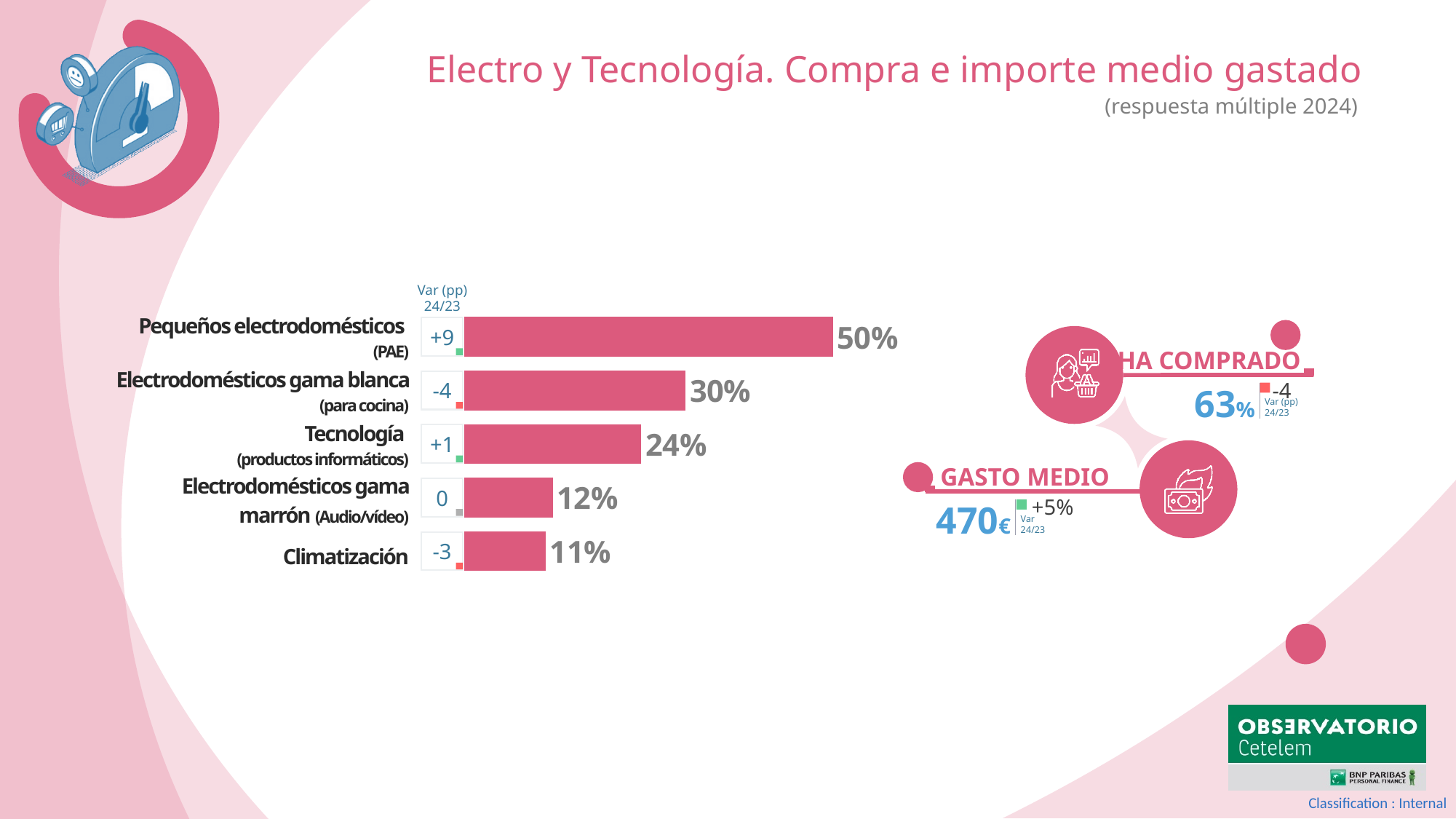
What is the Var (pp) 24/23 value shown for Electrodomésticos gama blanca? -4 What kind of chart is used to show the purchase percentages by category? Bar chart Which category has the highest percentage in the bar chart? Pequeños electrodomésticos (PAE) What percentage is shown for Climatización? 11% What is the difference in percentage points between Pequeños electrodomésticos and Electrodomésticos gama blanca? 20 What is the Var (pp) 24/23 value shown for Pequeños electrodomésticos? +9 What percentage is shown for Tecnología (productos informáticos)? 24% What percentage is shown for Pequeños electrodomésticos (PAE)? 50% How many categories are shown in the bar chart? 5 Which is larger, the value for Tecnología or the value for Electrodomésticos gama marrón? Tecnología What is the title of the slide? Electro y Tecnología. Compra e importe medio gastado Which category has the lowest percentage in the bar chart? Climatización